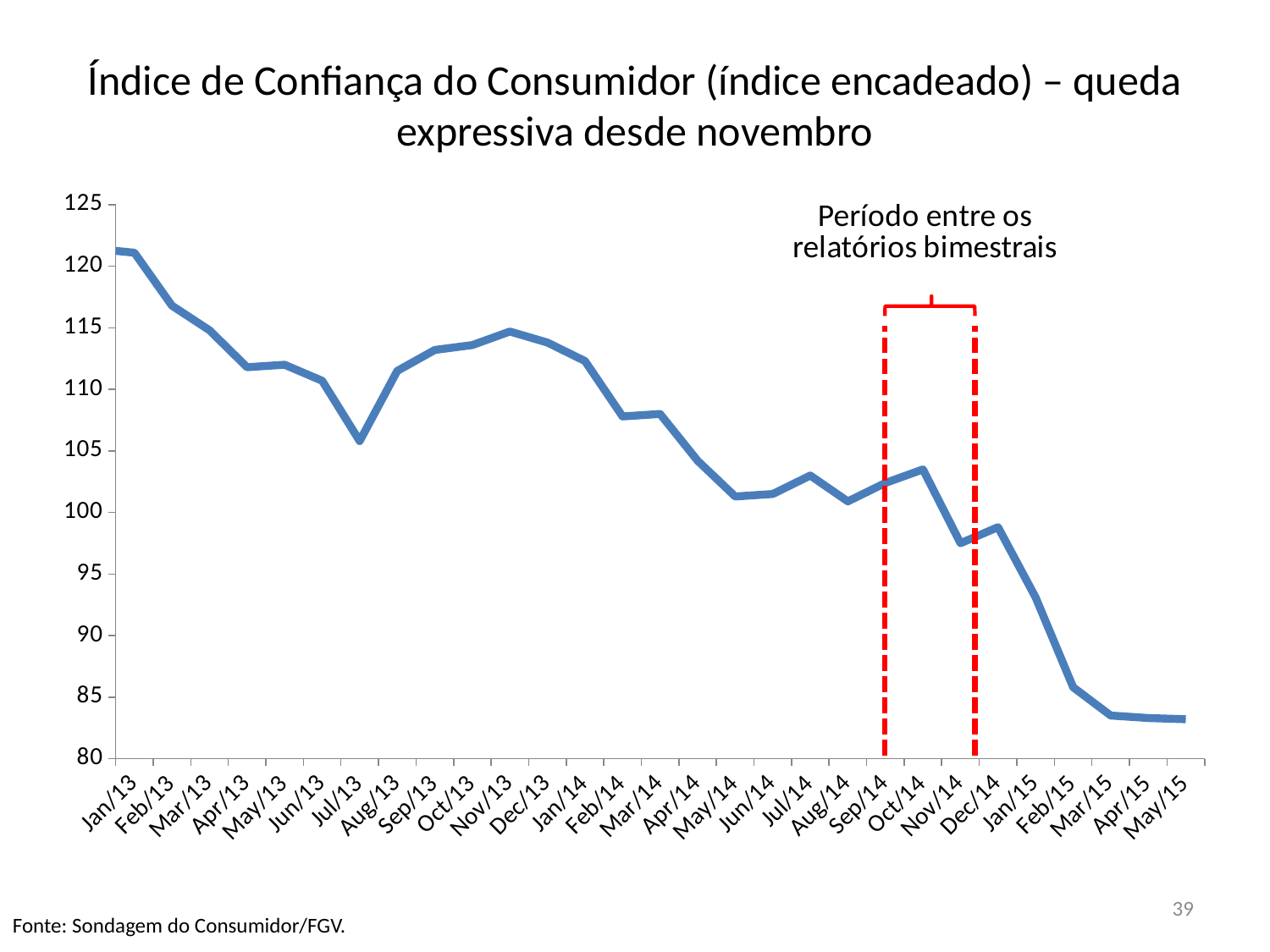
Is the value for Jul/13 greater or less than 110? less Is the value for Feb/15 greater or less than 90? less Which is larger, the value for Jan/13 or the value for May/15? Jan/13 Is the value for Nov/14 greater or less than 100? less What does the red dashed box annotation on the chart say? Período entre os relatórios bimestrais Overall, do the values rise or fall from Jan/13 to May/15? fall What kind of chart is shown on the slide? line chart How many monthly points are plotted on the x axis, from Jan/13 to May/15? 29 Which is larger, the value for Oct/14 or the value for Feb/15? Oct/14